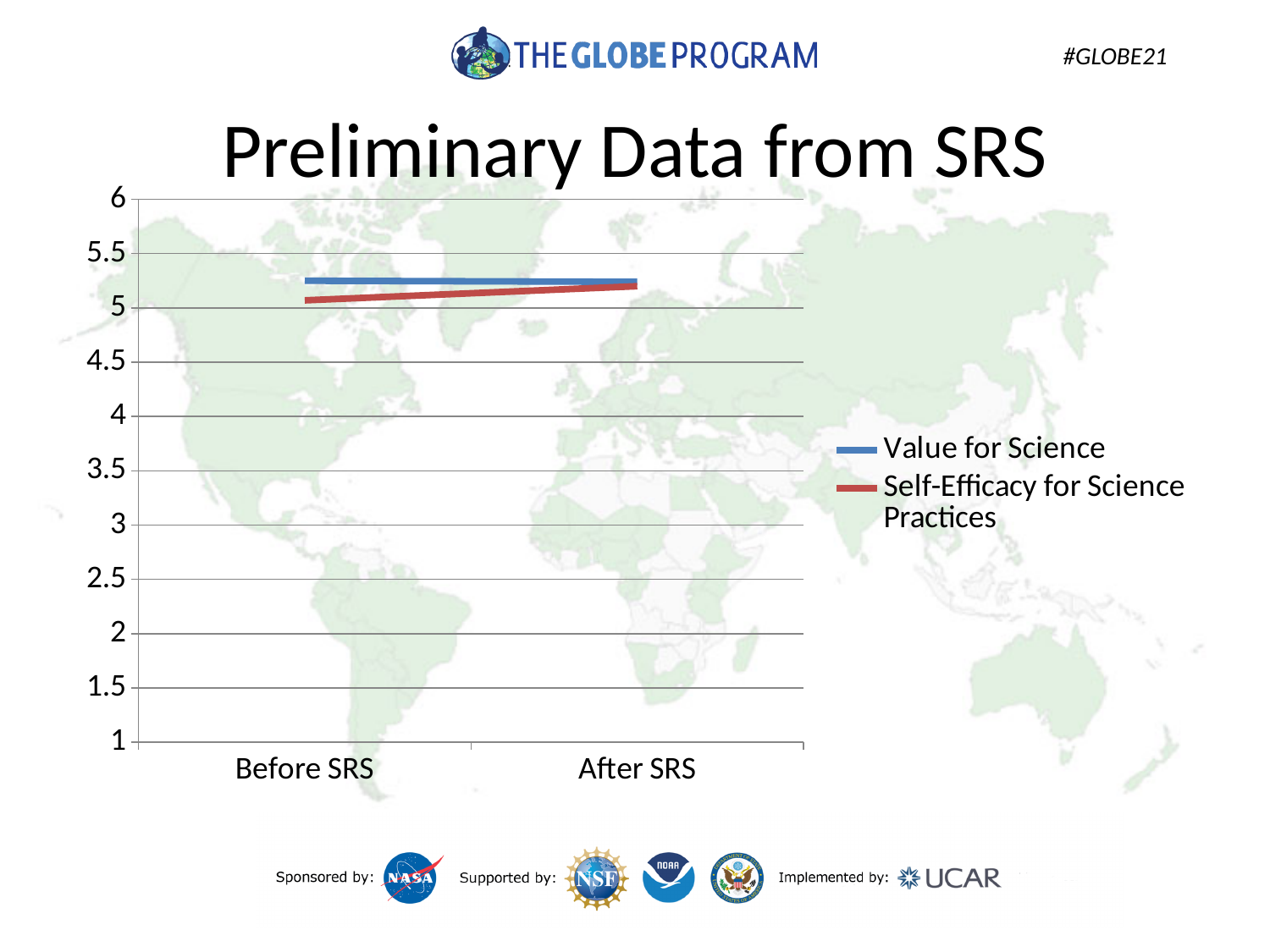
How many series does the legend list? 2 How many categories are shown on the x axis? 2 Is the value for Self-Efficacy for Science Practices at After SRS greater or less than 5? greater Is the value for Value for Science at After SRS greater or less than 5.5? less At Before SRS, which series has the higher value, Value for Science or Self-Efficacy for Science Practices? Value for Science What is the title of the chart? Preliminary Data from SRS Is the value for Self-Efficacy for Science Practices at Before SRS greater or less than 5.5? less What are the two categories on the x axis? Before SRS and After SRS What kind of chart is shown on the slide? line chart Does the Self-Efficacy for Science Practices series rise or fall from Before SRS to After SRS? rise Which colour represents the Value for Science series? blue